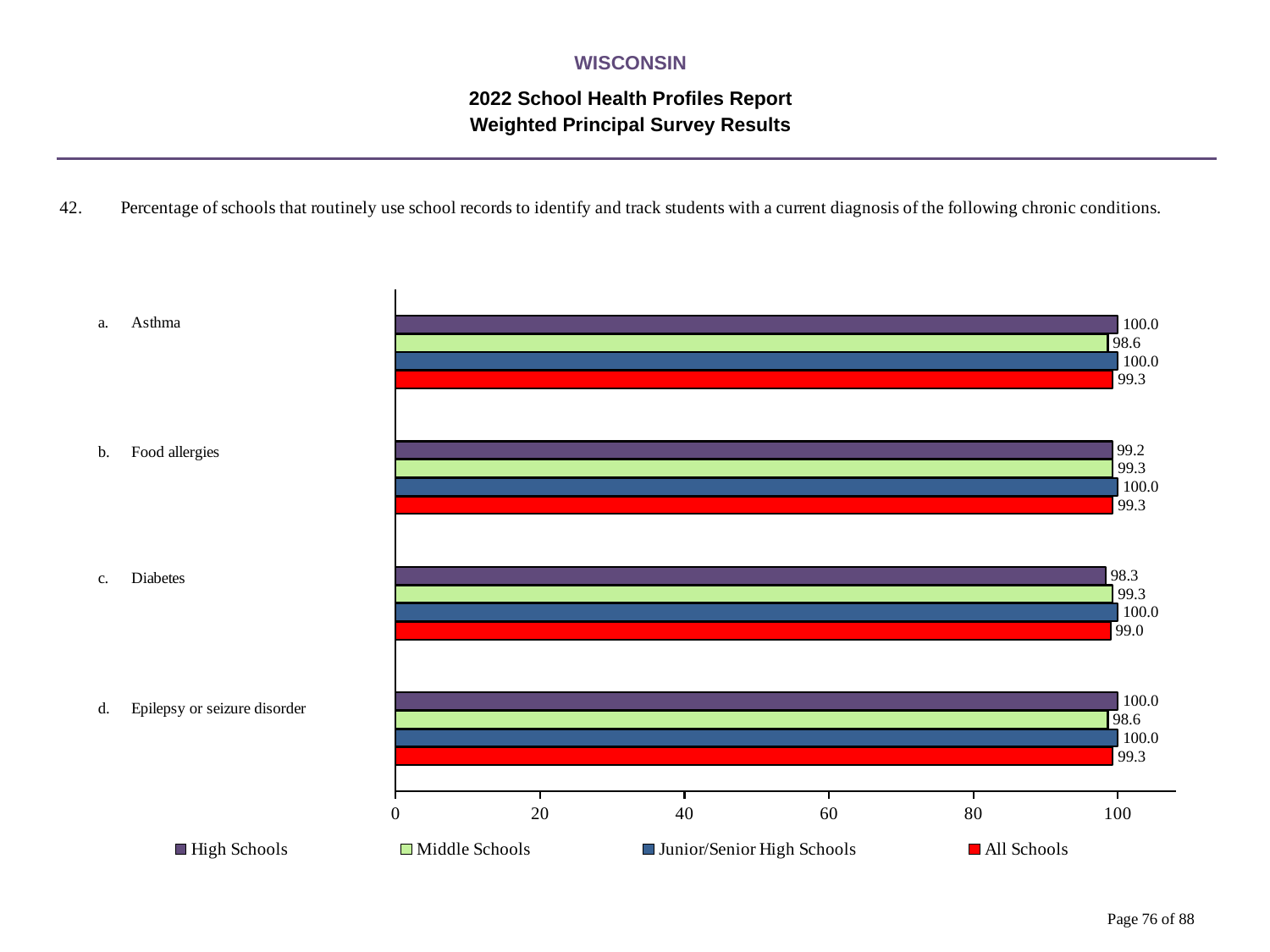
What is the value for High Schools for Asthma? 100.0 How many series does the legend list? 4 What is the value for All Schools for Diabetes? 99.0 Which category has the lowest value for High Schools? Diabetes What is the difference between the Junior/Senior High Schools and All Schools values for Diabetes? 1.0 How many categories are shown on the chart? 4 What is the difference between the High Schools and Middle Schools values for Asthma? 1.4 What kind of chart is shown on the slide? bar chart What is the value for Middle Schools for Food allergies? 99.3 What is the value for Middle Schools for Epilepsy or seizure disorder? 98.6 Which is larger for Food allergies: the High Schools value or the Junior/Senior High Schools value? Junior/Senior High Schools Which series is shown in red in the legend? All Schools